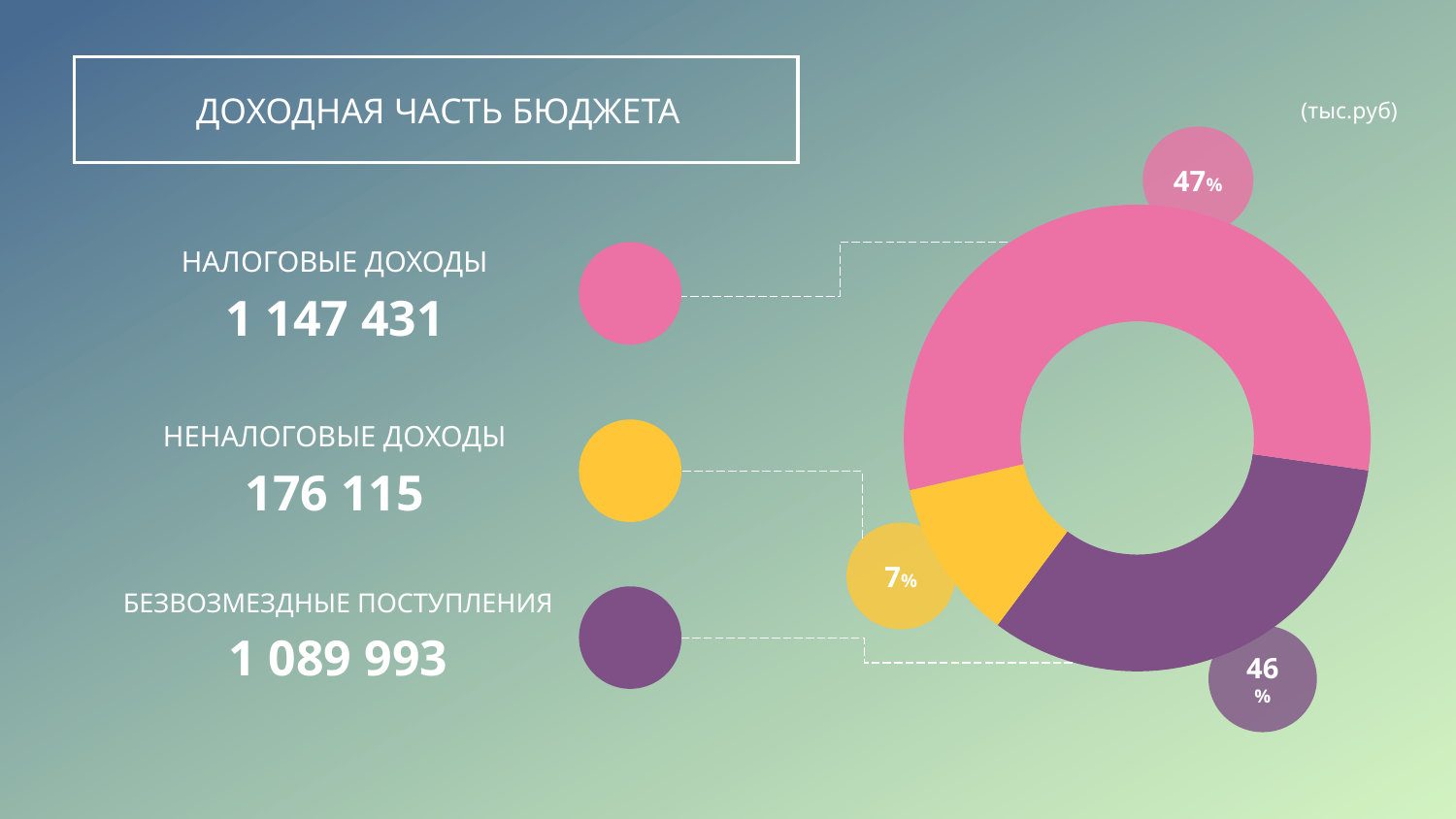
What is the title of the chart on the slide? ДОХОДНАЯ ЧАСТЬ БЮДЖЕТА Which category has the largest value? Налоговые доходы What is the value for Неналоговые доходы? 176 115 What kind of chart is shown on the slide? Donut (pie) chart What share of the donut chart does Неналоговые доходы take? 7% What share of the donut chart does Налоговые доходы take? 47% How many categories does the donut chart show? 3 What share of the donut chart does Безвозмездные поступления take? 46% What is the value for Безвозмездные поступления? 1 089 993 What is the value for Налоговые доходы? 1 147 431 What is the difference between Налоговые доходы and Безвозмездные поступления? 57 438 Which category has the smallest value? Неналоговые доходы